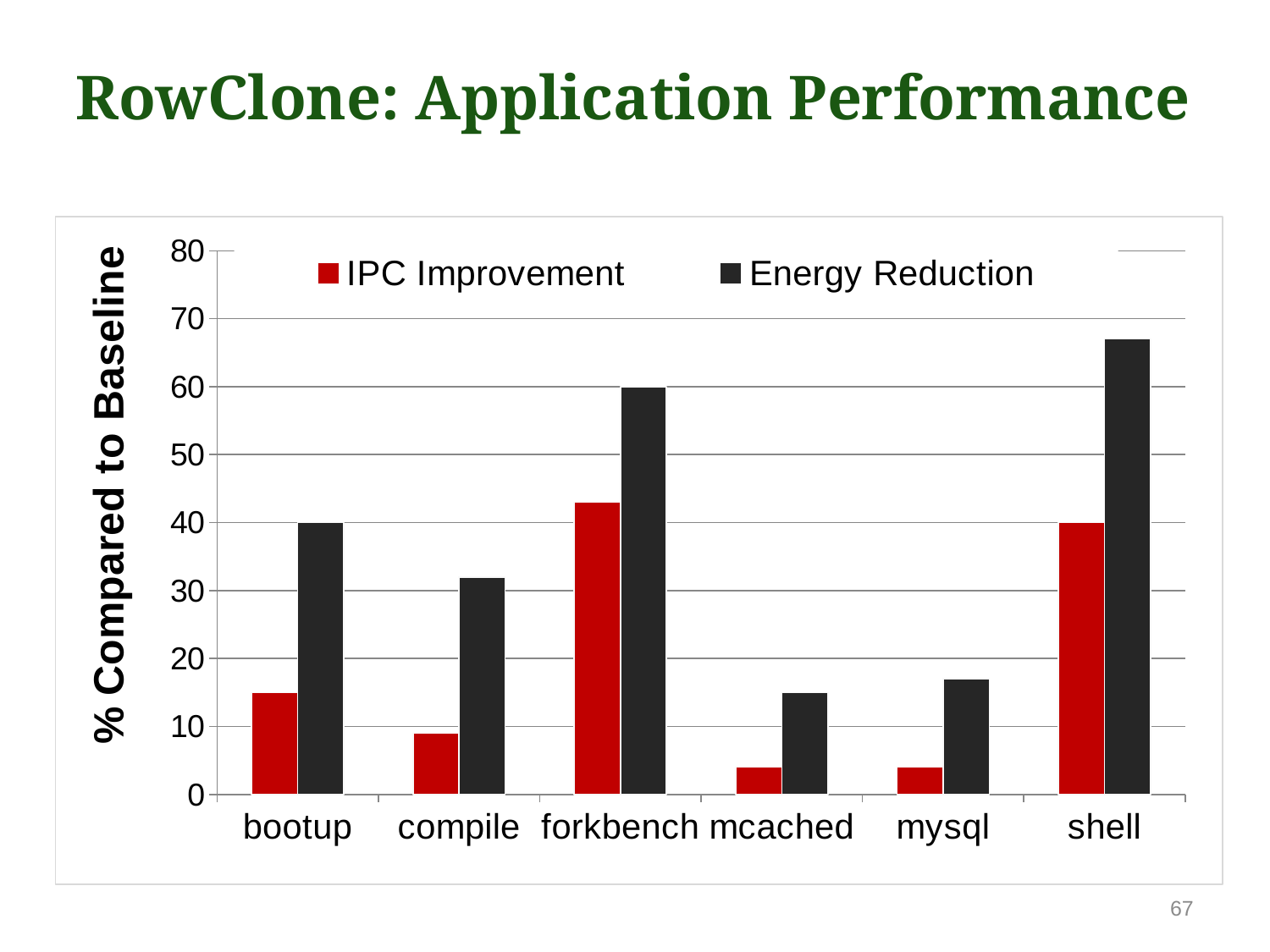
How many series does the legend list? 2 Is the IPC Improvement for mcached greater or less than 10? less What is the label of the y axis? % Compared to Baseline Is the Energy Reduction for shell greater or less than 60? greater Which is larger, the IPC Improvement for bootup or the IPC Improvement for shell? shell What type of chart is shown on the slide? bar chart Is the Energy Reduction for forkbench greater or less than 50? greater How many applications are shown on the x axis? 6 Which application has the highest IPC Improvement? forkbench Which is larger, the Energy Reduction for bootup or the Energy Reduction for compile? bootup Which application has the highest Energy Reduction? shell